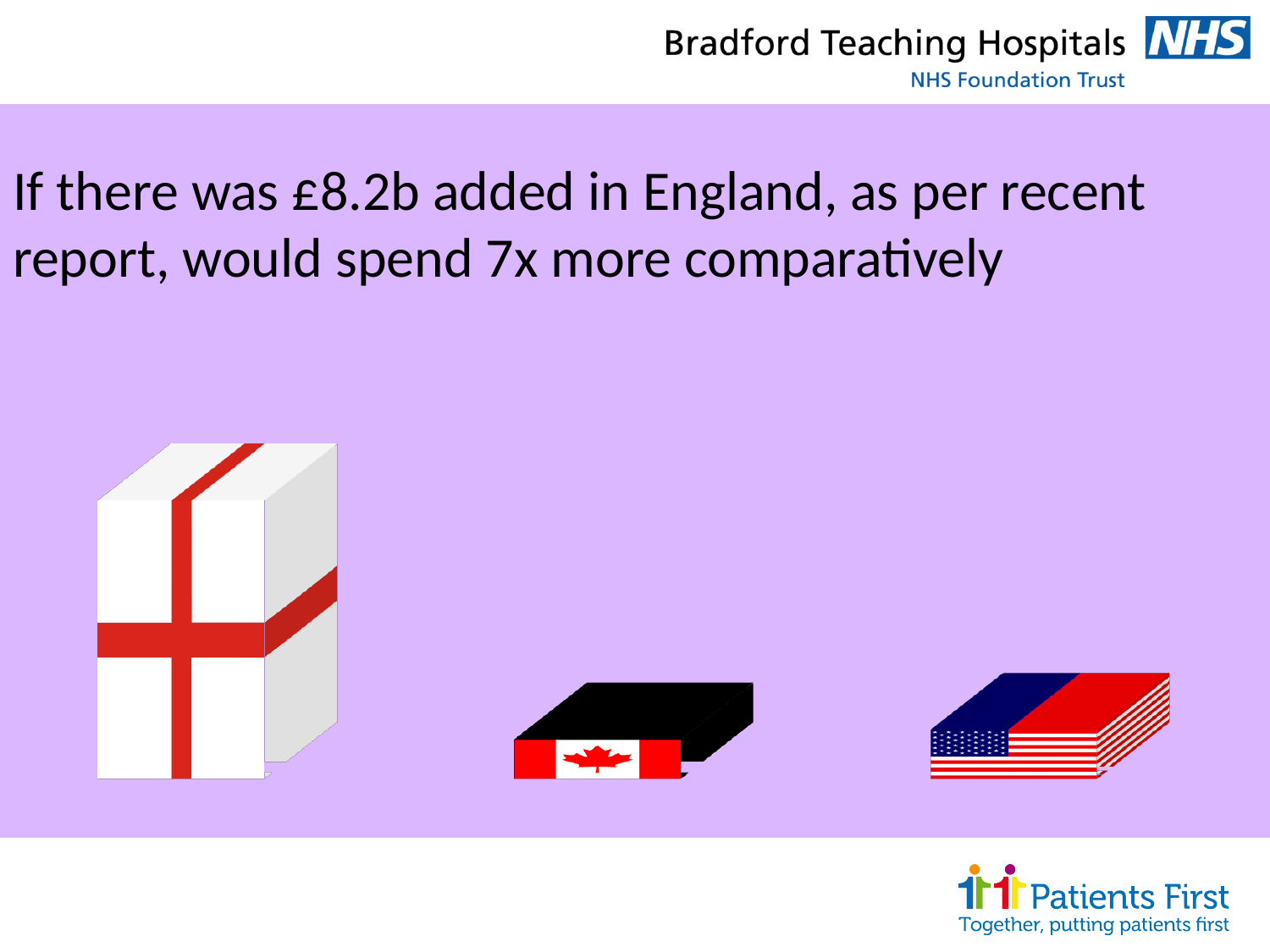
Which country's bar is the tallest in the chart? England Is the bar for the USA taller or shorter than the bar for England? shorter How many bars (countries) are shown in the chart? 3 What kind of chart is shown on the slide? bar chart How are the bars in the chart identified? by national flags According to the slide text, how many times more would England spend comparatively if £8.2b were added? 7x Is the bar for England taller or shorter than the bar for Canada? taller